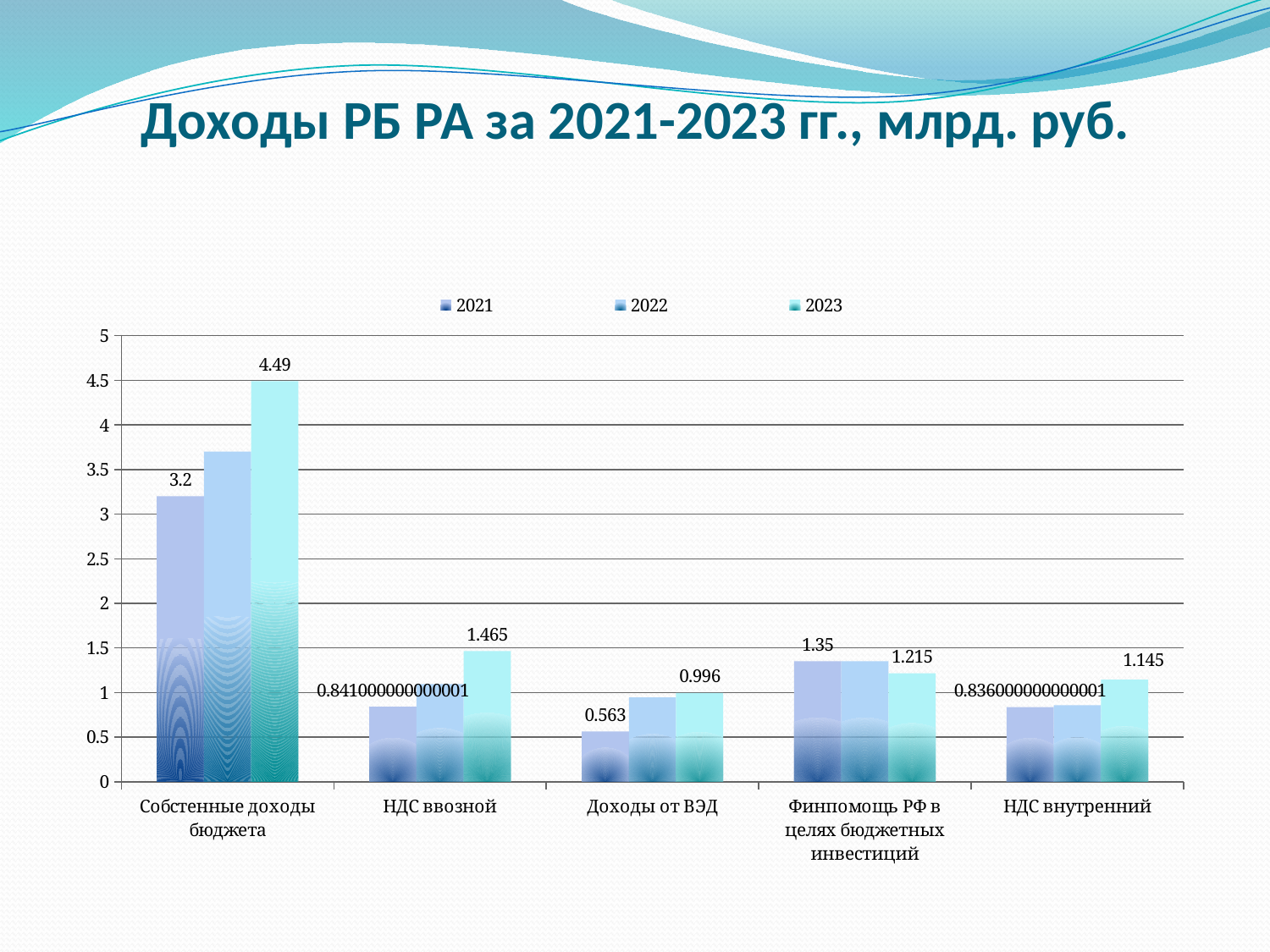
Which category has the highest 2023 value? Собстенные доходы бюджета What is the difference between the 2023 and 2021 values for Собстенные доходы бюджета? 1.29 What is the 2021 value for Финпомощь РФ в целях бюджетных инвестиций? 1.35 What is the 2023 value for Собстенные доходы бюджета? 4.49 What is the 2021 value for Собстенные доходы бюджета? 3.2 How many categories are shown on the x axis? 5 What type of chart is shown on the slide? bar chart What is the 2021 value for Доходы от ВЭД? 0.563 Which category has the lowest 2021 value? Доходы от ВЭД How many series does the legend list? 3 What is the 2023 value for НДС ввозной? 1.465 Is the 2022 value for Собстенные доходы бюджета greater or less than 3.5? greater